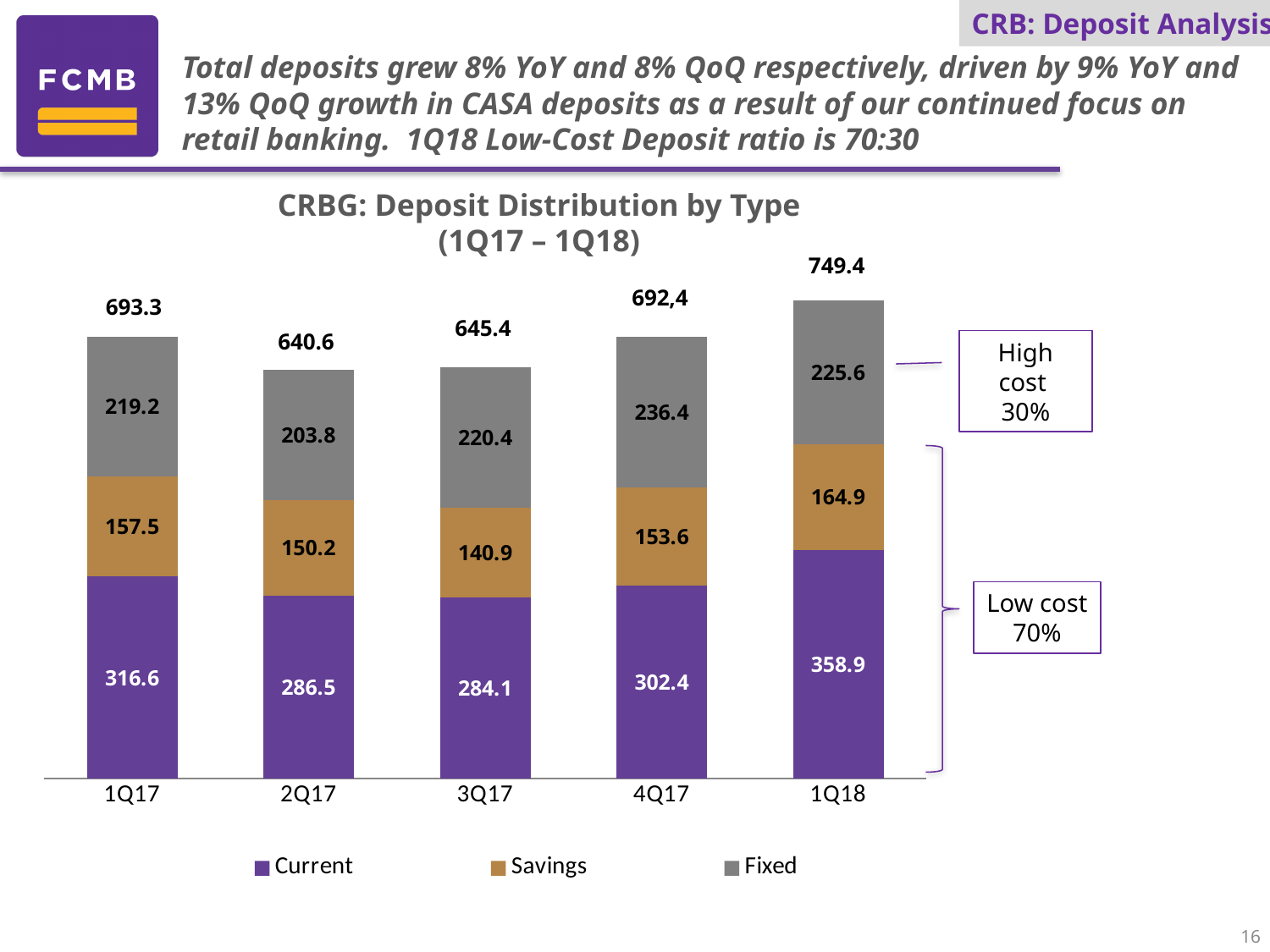
Which quarter has the highest total deposits? 1Q18 What is the Current deposit value for 1Q18? 358.9 What is the Fixed deposit value for 4Q17? 236.4 Which is larger, the Fixed deposit value for 1Q17 or for 3Q17? 3Q17 What is the title of the chart? CRBG: Deposit Distribution by Type (1Q17 – 1Q18) Which quarter has the lowest Savings deposit value? 3Q17 How many series does the legend list? 3 How many quarters are shown on the x axis? 5 What kind of chart is shown on the slide? Stacked bar chart What is the difference between the Current deposit values for 1Q18 and 4Q17? 56.5 What is the Savings deposit value for 3Q17? 140.9 What is the total deposit value shown above the 2Q17 bar? 640.6